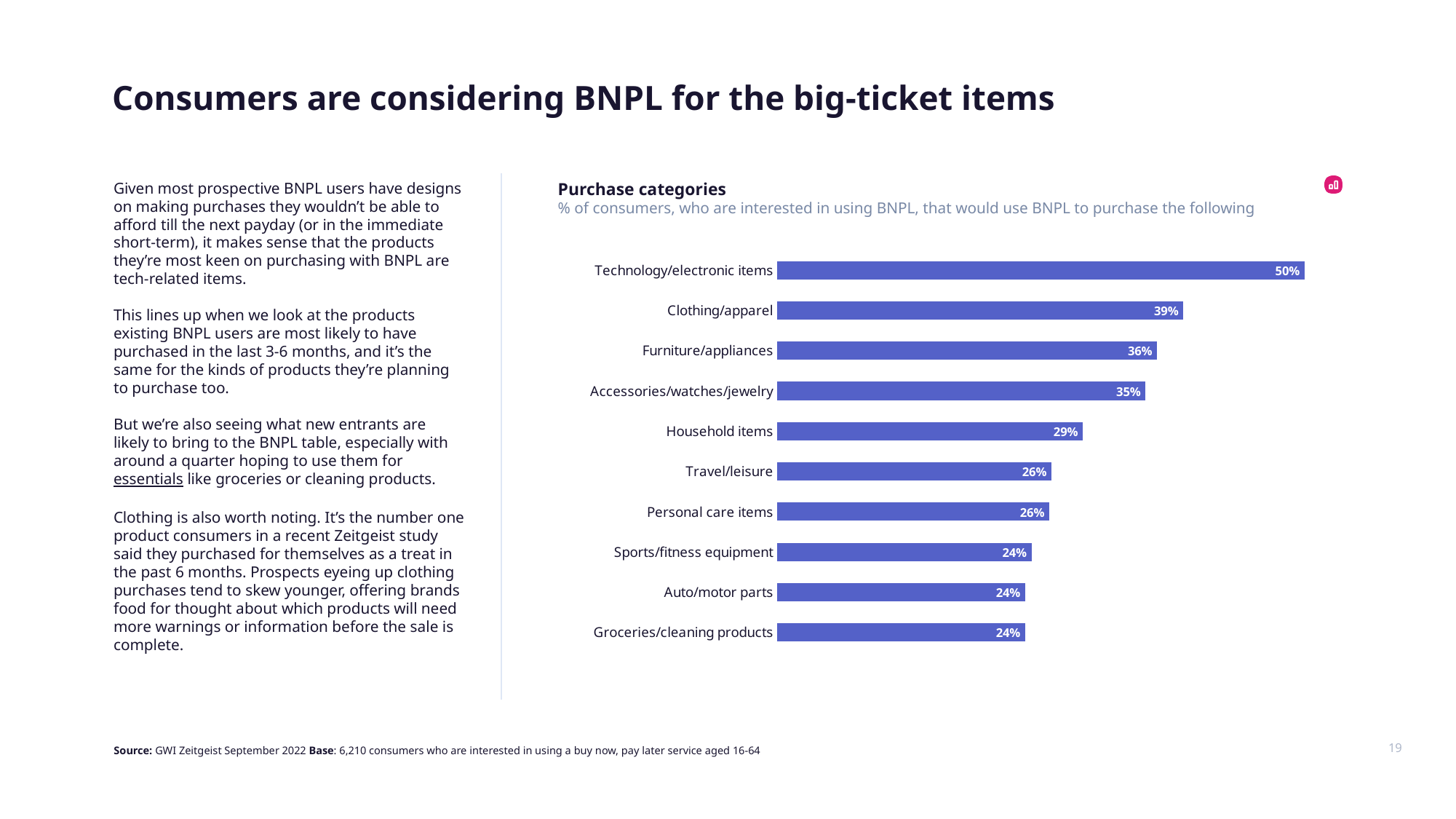
What is the value shown for Household items? 29% What percentage of consumers interested in BNPL would use it to purchase Technology/electronic items? 50% Which purchase category has the highest value? Technology/electronic items What is the title of the chart? Purchase categories What is the difference between the values for Furniture/appliances and Household items? 7% How many purchase categories are shown in the chart? 10 What is the value shown for Furniture/appliances? 36% Which is larger, the value for Accessories/watches/jewelry or the value for Travel/leisure? Accessories/watches/jewelry What kind of chart is shown on the slide? Bar chart How many categories share the lowest value of 24%? 3 What is the difference between the values for Technology/electronic items and Clothing/apparel? 11% What is the value shown for Clothing/apparel? 39%